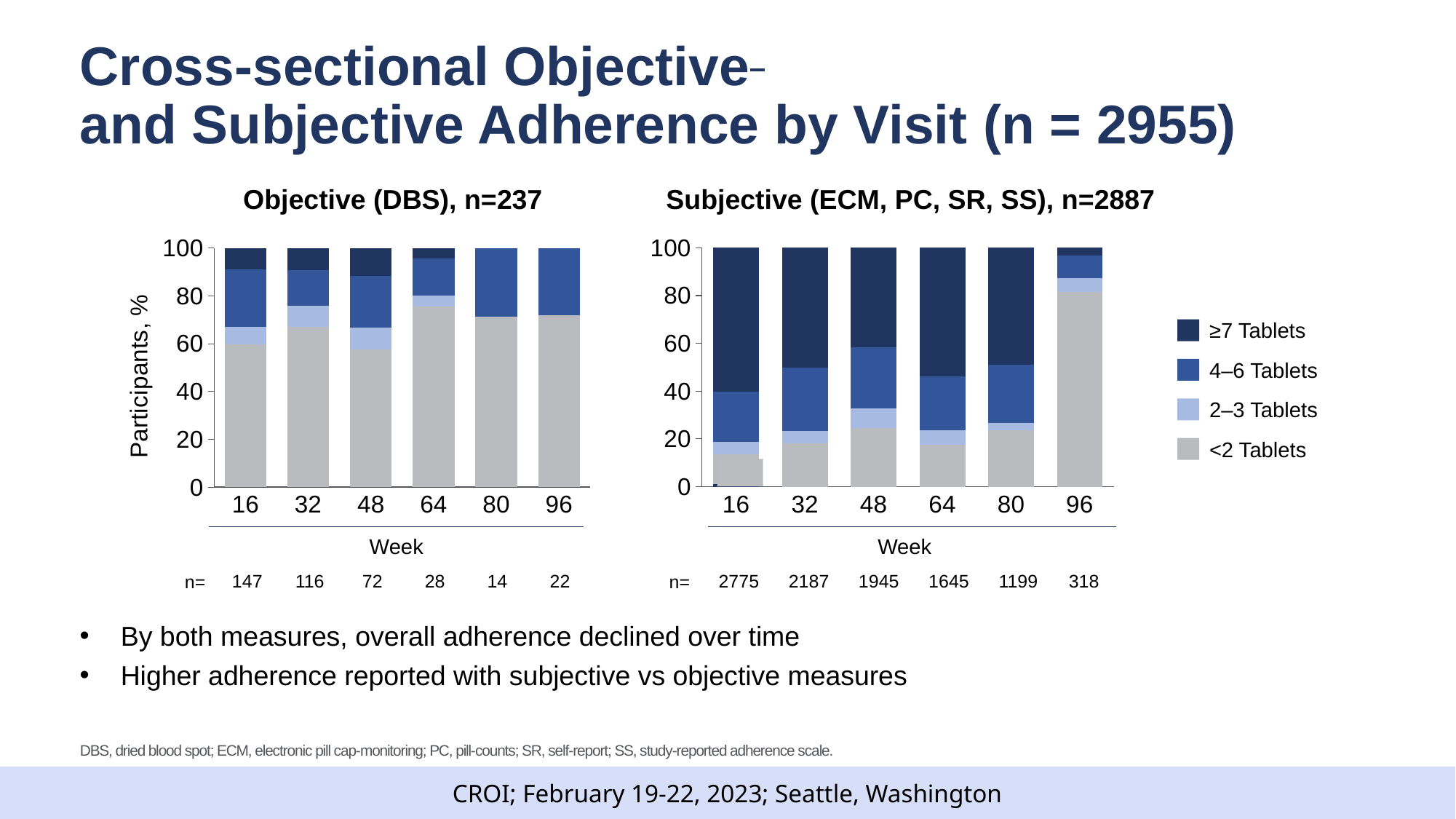
In the Objective (DBS) chart, which week has the smallest n? 80 In the Subjective (ECM, PC, SR, SS) chart, which week has the largest n? 16 In the Subjective (ECM, PC, SR, SS) chart, what is the n value at week 80? 1199 In the Subjective (ECM, PC, SR, SS) chart, is the <2 Tablets share at week 16 greater or less than 20? less In the Objective (DBS) chart, what is the n value at week 16? 147 In the Objective (DBS) chart, what is the difference between the n at week 16 and the n at week 32? 31 How many series does the legend list? 4 What is the y-axis label on the Objective (DBS) chart? Participants, % What kind of chart is the Objective (DBS) chart? stacked bar chart In the Subjective (ECM, PC, SR, SS) chart, how many weeks are shown on the x axis? 6 In the Subjective (ECM, PC, SR, SS) chart, does the <2 Tablets share rise or fall from week 16 to week 96? rise In the Subjective (ECM, PC, SR, SS) chart, is the <2 Tablets share at week 96 greater or less than 60? greater